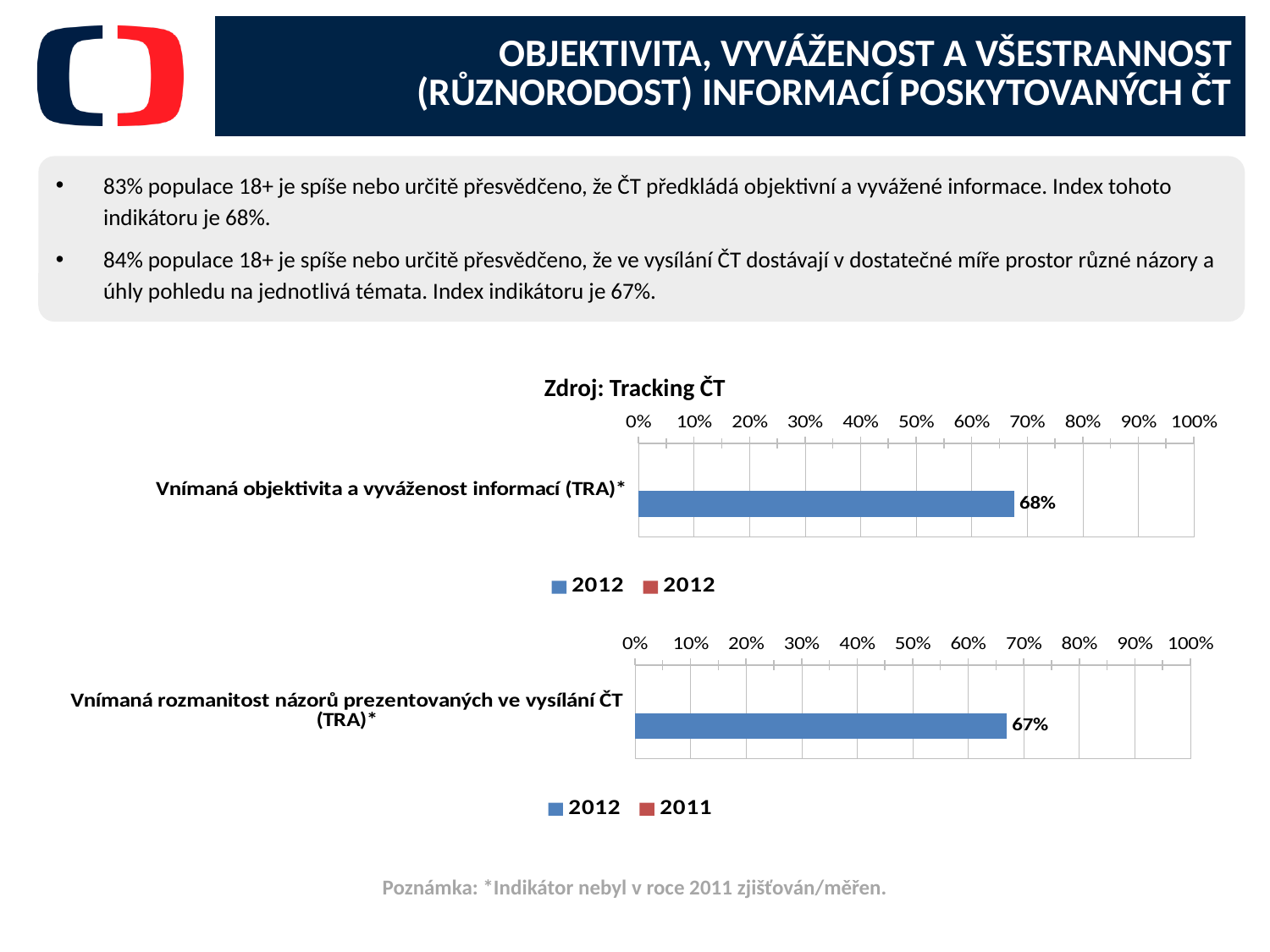
In the bottom chart, is the value for Vnímaná rozmanitost názorů prezentovaných ve vysílání ČT (TRA)* greater or less than 70%? less In the top chart, what is the value for Vnímaná objektivita a vyváženost informací (TRA)*? 68% What kind of chart is the top chart? bar chart What is the difference between the value in the top chart (68%) and the value in the bottom chart (67%)? 1% What kind of chart is the bottom chart? bar chart How many series does the legend of the top chart list? 2 In the top chart, is the value for Vnímaná objektivita a vyváženost informací (TRA)* greater or less than 60%? greater Which is larger: the 68% value in the top chart or the 67% value in the bottom chart? the top chart value (68%) How many series does the legend of the bottom chart list? 2 How many categories are plotted in the bottom chart? 1 In the bottom chart, what is the value for Vnímaná rozmanitost názorů prezentovaných ve vysílání ČT (TRA)*? 67% What are the legend entries of the bottom chart? 2012 and 2011